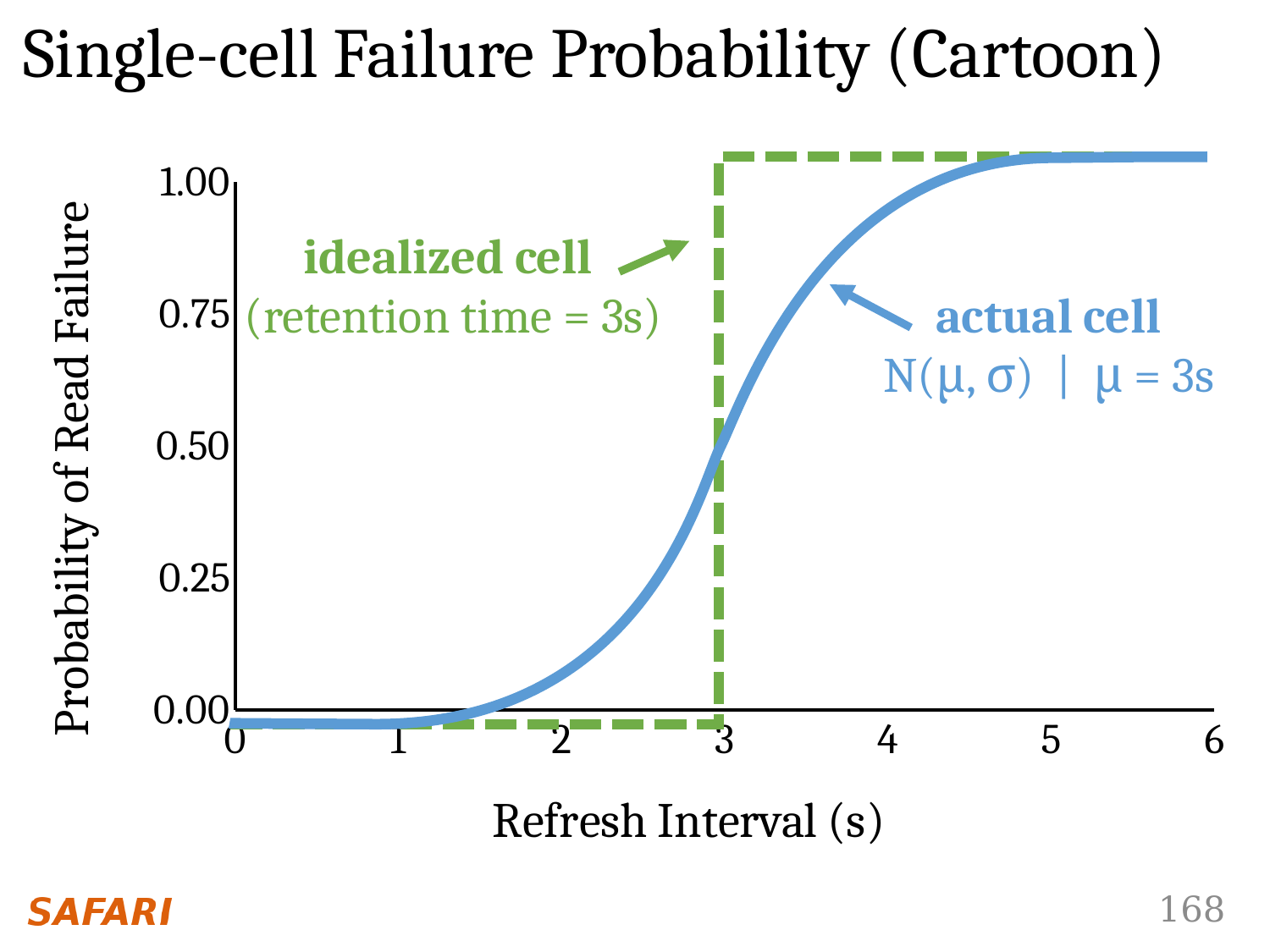
What is the title of the chart on the slide? Single-cell Failure Probability (Cartoon) Is the value for the actual cell at a refresh interval of 2 s greater or less than 0.25? less At a refresh interval of 4 s, which curve has the higher probability of read failure, the actual cell or the idealized cell? idealized cell Is the value for the idealized cell at a refresh interval of 4 s greater or less than 0.75? greater What kind of chart is shown on the slide? line chart Is the value for the actual cell at a refresh interval of 4 s greater or less than 0.75? greater Does the probability of read failure for the actual cell rise or fall as the refresh interval increases? rise What value of μ is given for the actual cell? 3s What retention time is given for the idealized cell? 3s How many curves (series) are plotted on the chart? 2 At a refresh interval of 2 s, which curve has the higher probability of read failure, the actual cell or the idealized cell? actual cell What is the label of the x axis? Refresh Interval (s)